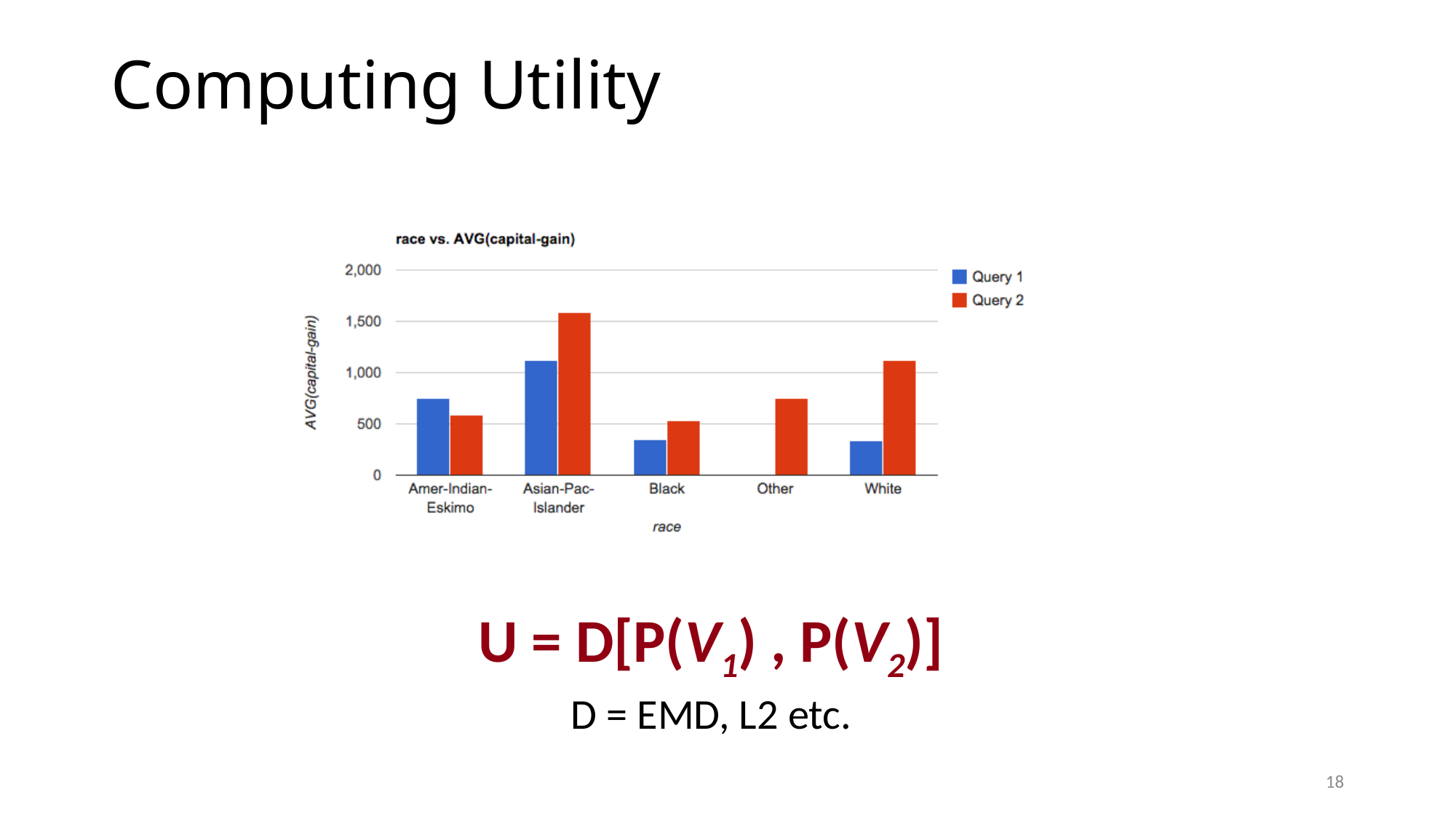
Which colour represents Query 2 in the chart? Red Which race category has the highest Query 2 value? Asian-Pac-Islander Is the Query 2 value for Asian-Pac-Islander greater or less than 1,500? greater Is the Query 1 value for Black greater or less than 500? less How many series does the legend of the chart list? 2 Which race category has the highest Query 1 value? Asian-Pac-Islander For the Amer-Indian-Eskimo category, which is larger: the Query 1 value or the Query 2 value? Query 1 What is the title of the chart? race vs. AVG(capital-gain) What kind of chart is shown on the slide? Bar chart How many race categories are shown on the x axis of the chart? 5 For the White category, which is larger: the Query 1 value or the Query 2 value? Query 2 Is the Query 2 value for White greater or less than 1,000? greater